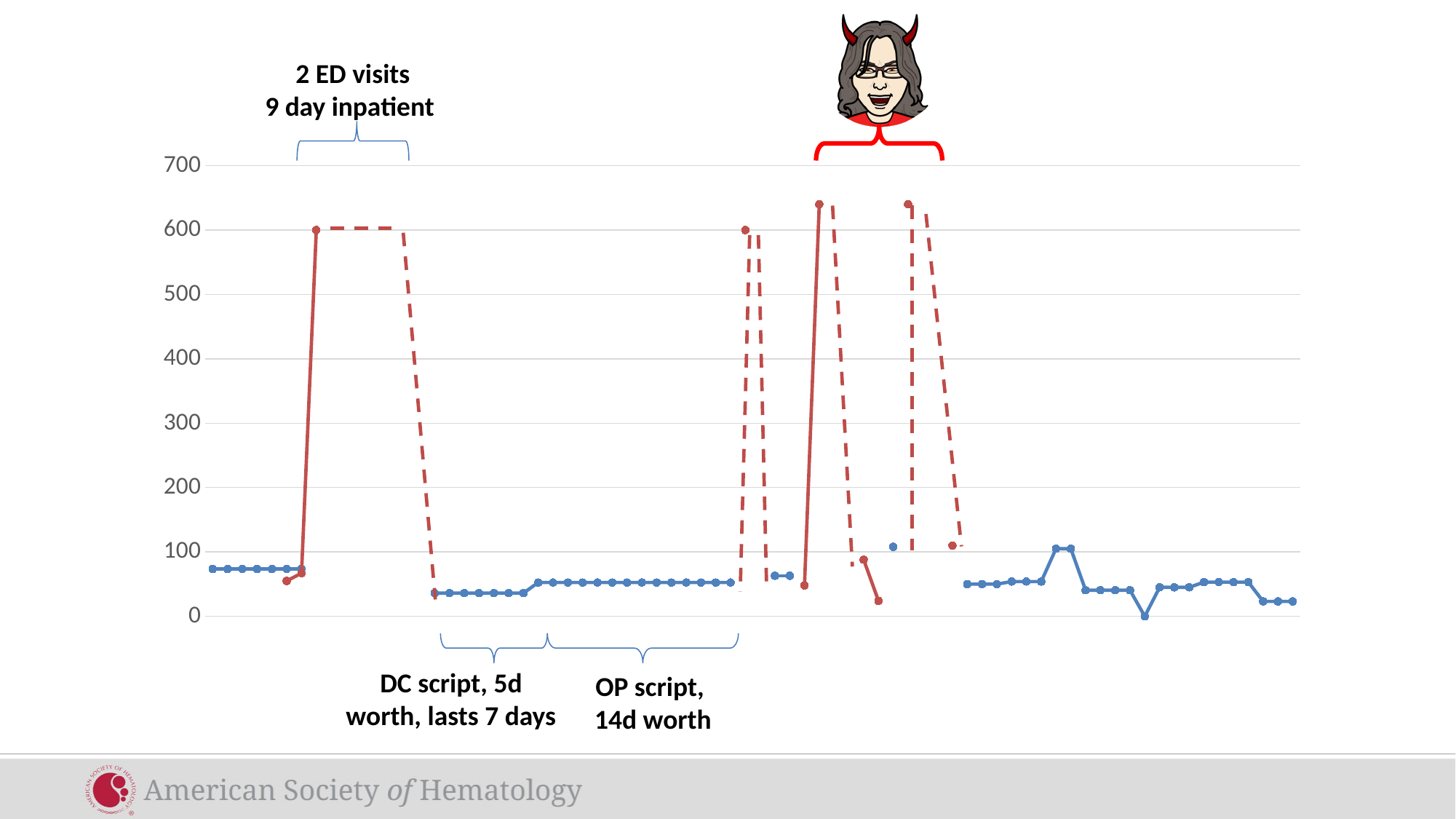
How many tick labels are shown on the vertical axis? 8 Is the value of the first red plateau greater or less than 500? greater What is the highest value labelled on the vertical axis? 700 Are the two tallest red peaks on the right side of the chart greater or less than 600? greater Are the blue values at the far left of the chart greater or less than 100? less What kind of chart is shown on the slide? line chart Do the blue values rise or fall from the start of the chart to the end? fall What annotation text appears above the bracket over the first red plateau? 2 ED visits 9 day inpatient Which series reaches higher values overall, the red series or the blue series? the red series Which is higher: the first red plateau or the two tallest red peaks on the right? the two tallest red peaks on the right What value does the first red plateau (under the '2 ED visits / 9 day inpatient' bracket) sit on? 600